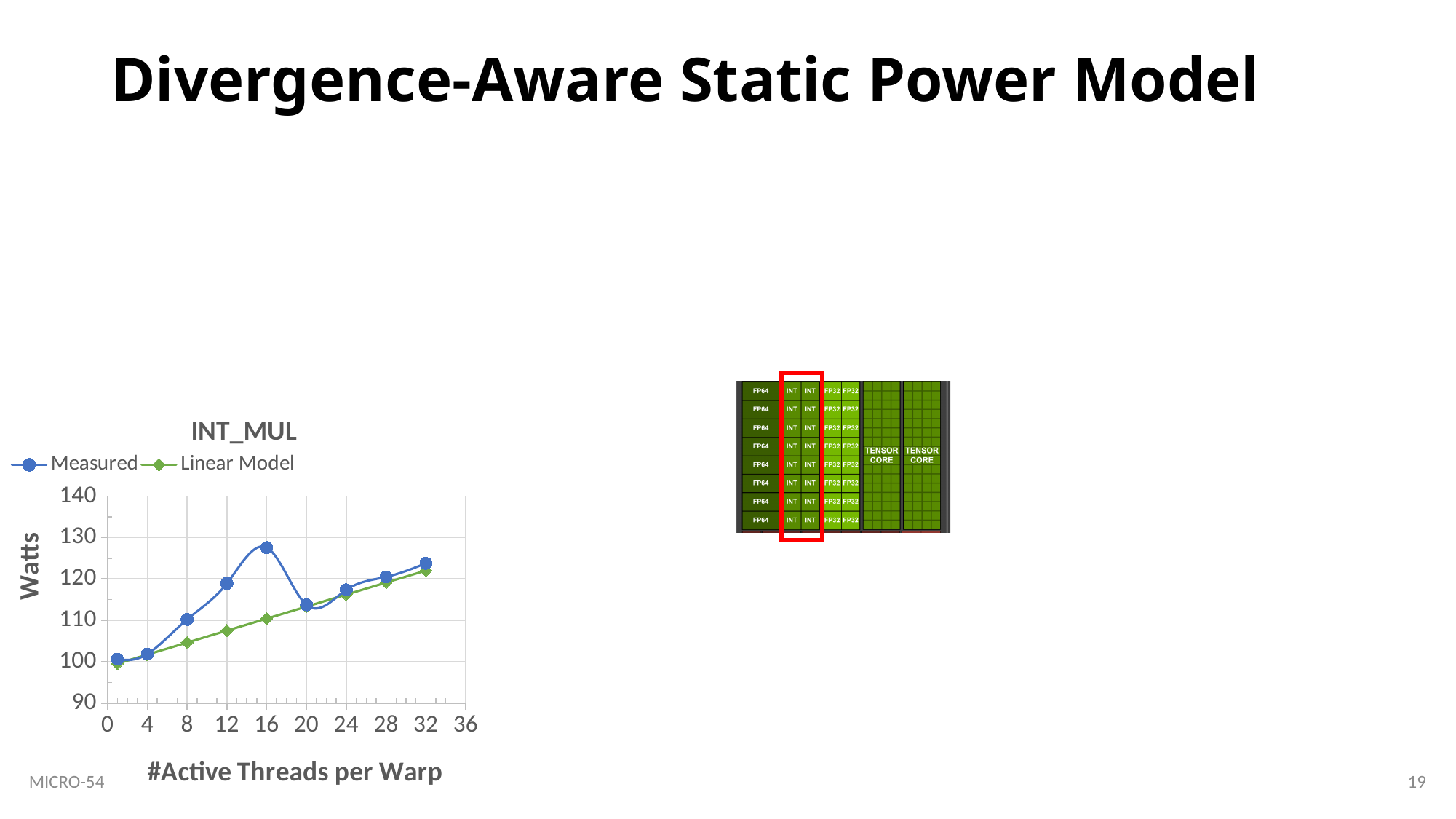
Does the Linear Model series rise or fall as the number of active threads per warp increases in the INT_MUL chart? rise In the INT_MUL chart, at 12 active threads per warp, which series has the larger value, Measured or Linear Model? Measured How many series does the legend of the INT_MUL chart list? 2 At which number of active threads per warp does the Measured series reach its highest value in the INT_MUL chart? 16 What is the label of the y axis in the INT_MUL chart? Watts In the INT_MUL chart, is the Linear Model value at 16 active threads per warp greater or less than 120? less In the INT_MUL chart, is the Measured value at 8 active threads per warp greater or less than 100? greater In the INT_MUL chart, is the Linear Model value at 32 active threads per warp greater or less than 130? less What are the two series shown in the INT_MUL chart? Measured and Linear Model How many data points does the Measured series have in the INT_MUL chart? 9 What kind of chart is the INT_MUL chart? line chart